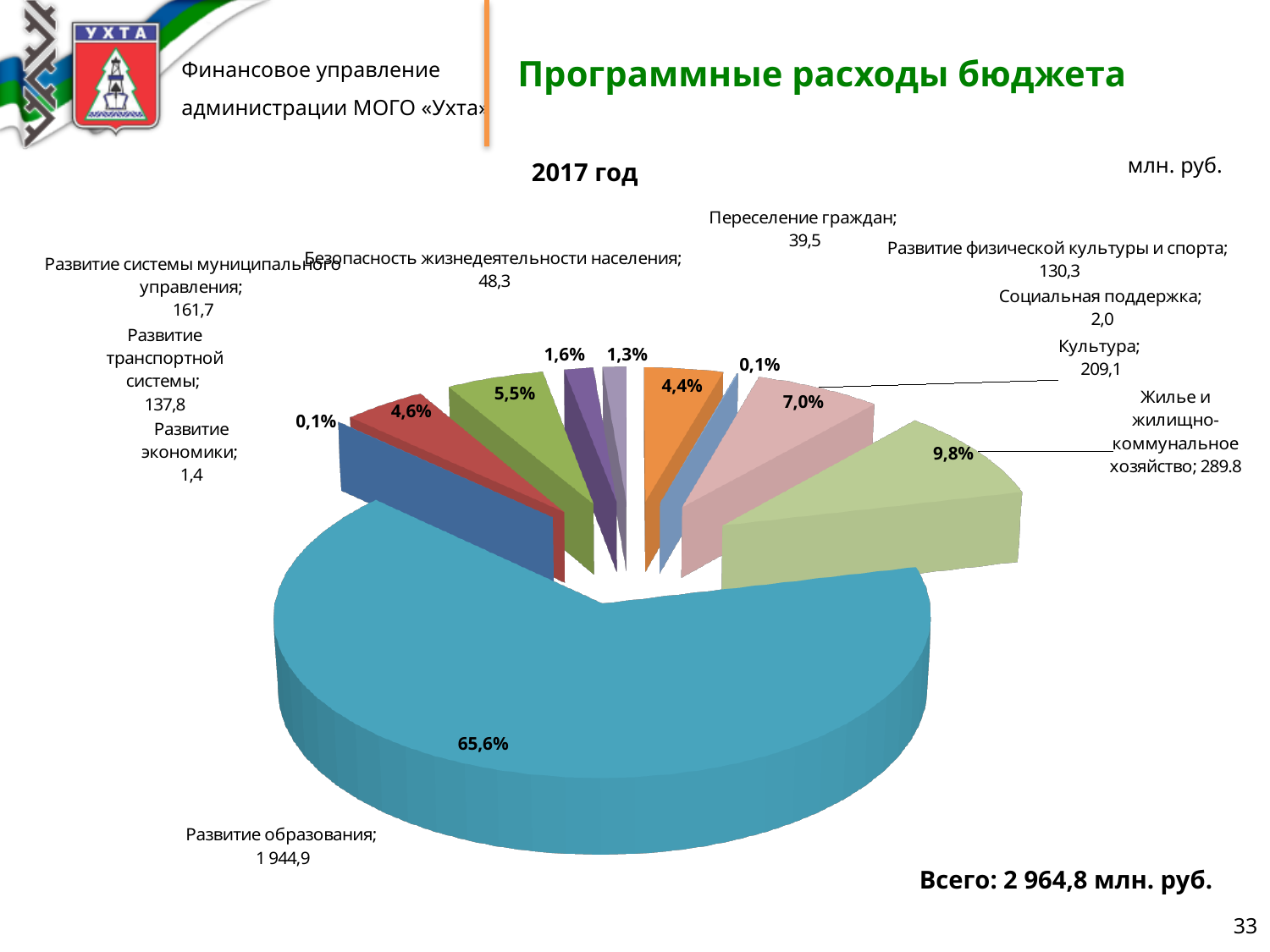
What kind of chart is shown on the slide? pie chart What is the difference between the values for Жилье и жилищно-коммунальное хозяйство and Культура? 80,7 What is the value for Культура? 209,1 What is the value for Развитие транспортной системы? 137,8 What is the value for Переселение граждан? 39,5 What is the value for Развитие образования? 1 944,9 What share of the pie does Жилье и жилищно-коммунальное хозяйство take? 9,8% Which category has the largest share of the pie? Развитие образования Which is larger: the value for Развитие системы муниципального управления or Развитие физической культуры и спорта? Развитие системы муниципального управления What total is stated on the slide for the programme expenditures? 2 964,8 млн. руб. How many categories does the pie chart show? 10 What share of the pie does Развитие образования take? 65,6%